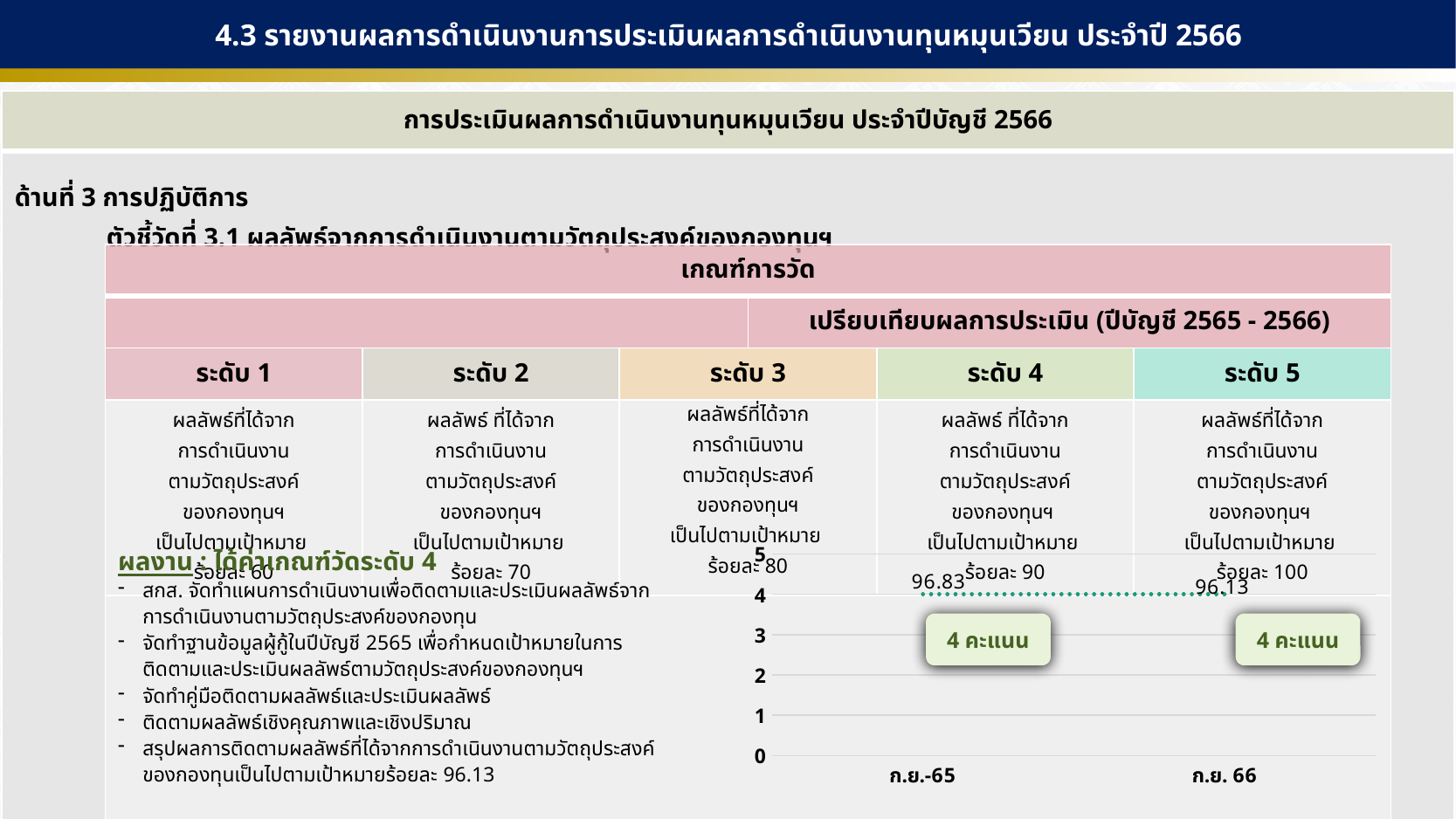
What value is labelled for ก.ย. 66 on the chart? 96.13 What value is labelled for ก.ย.-65 on the chart? 96.83 Which point on the chart has the lowest labelled value? ก.ย. 66 How many data points are plotted on the chart at the bottom right? 2 What score is shown in the green boxes under each point on the chart? 4 คะแนน What are the two category labels on the chart's horizontal axis? ก.ย.-65 and ก.ย. 66 What is the highest tick value shown on the chart's vertical axis? 5 Which labelled value is larger on the chart, ก.ย.-65 or ก.ย. 66? ก.ย.-65 What kind of chart is shown at the bottom right of the slide? line chart Which point on the chart has the highest labelled value? ก.ย.-65 What is the difference between the labelled values for ก.ย.-65 and ก.ย. 66? 0.70